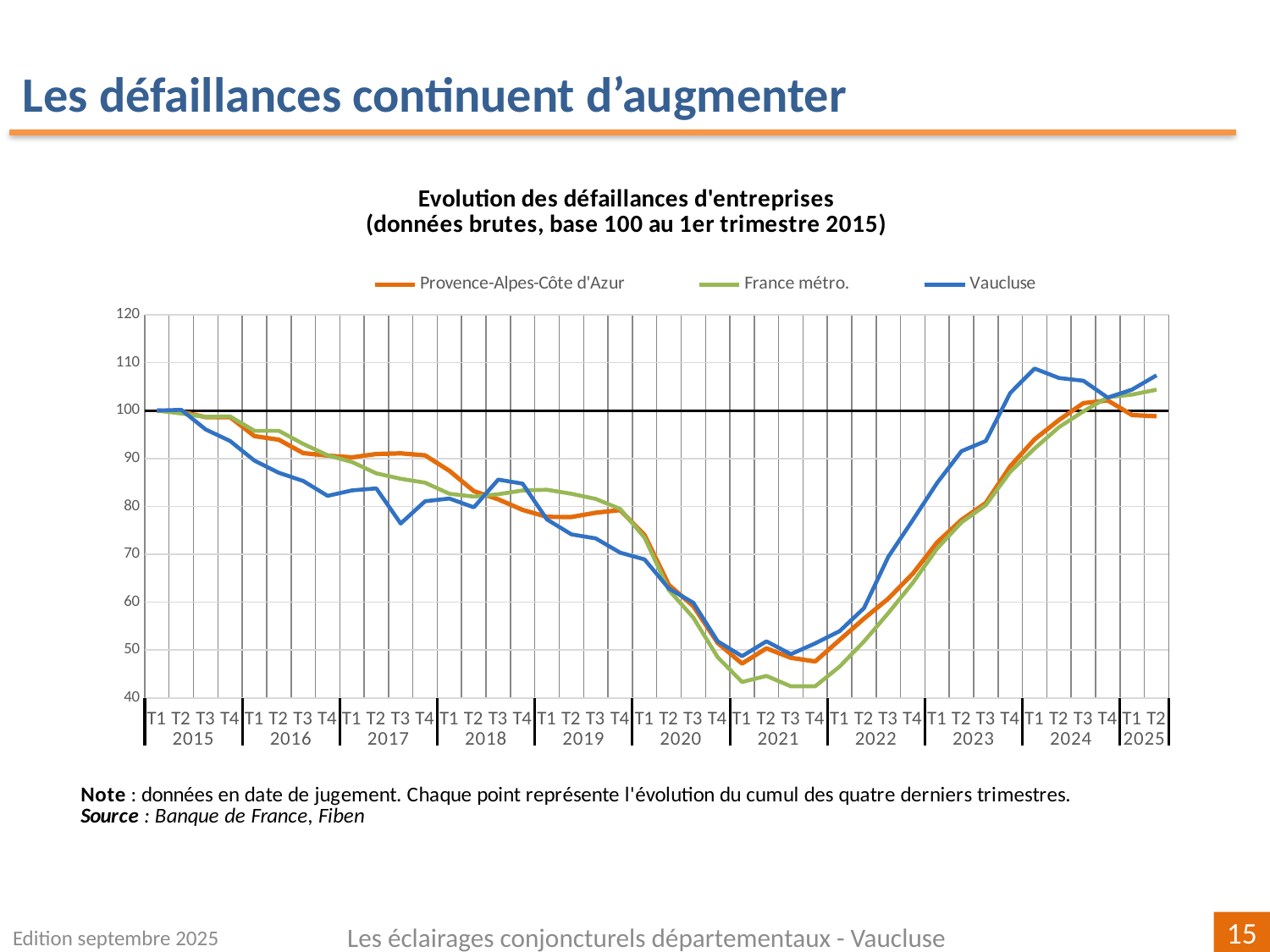
Is the value for France métro. at T4 2021 greater or less than 50? less At T1 2024, which series has the higher value, Vaucluse or France métro.? Vaucluse Is the value for Vaucluse at T1 2024 greater or less than 100? greater What kind of chart is shown on the slide? line chart What is the value of the Vaucluse series at T1 2015? 100 What is the title of the chart? Evolution des défaillances d'entreprises (données brutes, base 100 au 1er trimestre 2015) Is the value for Vaucluse at T3 2017 greater or less than 80? less Do the values of the Vaucluse series rise or fall between T1 2021 and T1 2024? rise How many series does the legend list? 3 Which series is drawn in blue? Vaucluse At T3 2017, which series has the higher value, Provence-Alpes-Côte d'Azur or Vaucluse? Provence-Alpes-Côte d'Azur